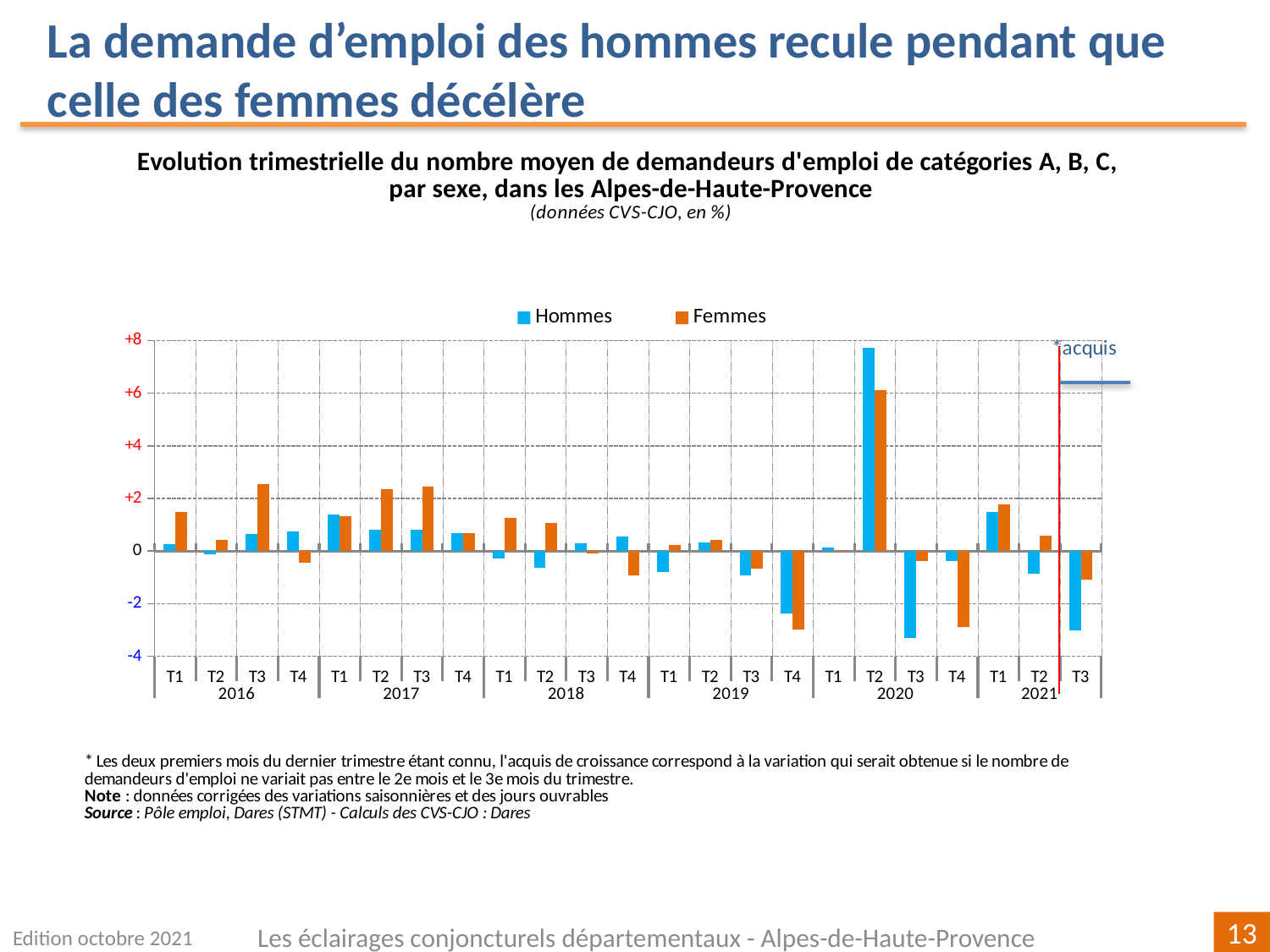
Is the Hommes value for T3 2020 greater or less than -2? less How many series does the legend list? 2 In which quarter is the Femmes value highest? T2 2020 What kind of chart is shown on the slide? bar chart In which quarter is the Hommes value highest? T2 2020 Is the Femmes value for T3 2016 greater or less than +2? greater How many quarters are plotted along the x axis? 23 In T4 2020, which series has the lower value, Hommes or Femmes? Femmes Is the Hommes value for T2 2020 greater or less than +6? greater In T2 2020, which series has the larger value, Hommes or Femmes? Hommes Which series is shown in orange? Femmes